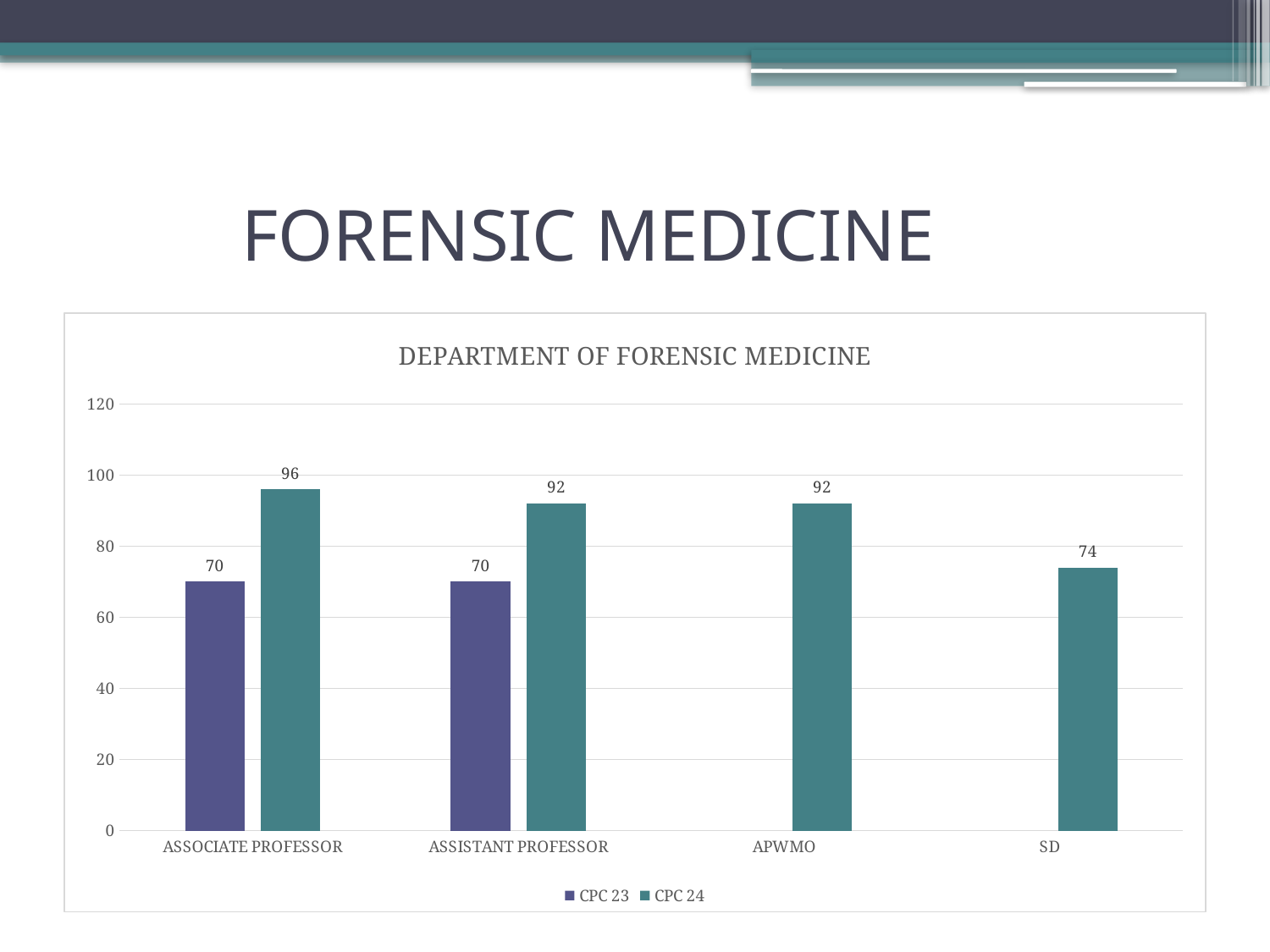
What is the CPC 24 value for APWMO? 92 How many series does the legend list? 2 What is the difference between the CPC 24 and CPC 23 values for ASSOCIATE PROFESSOR? 26 Which category has the highest CPC 24 value? ASSOCIATE PROFESSOR Which category has the lowest CPC 24 value? SD Which is larger for ASSISTANT PROFESSOR, the CPC 23 value or the CPC 24 value? CPC 24 What kind of chart is shown on the slide? Bar chart What is the CPC 23 value for ASSISTANT PROFESSOR? 70 How many categories are shown on the x axis? 4 What is the CPC 24 value for ASSOCIATE PROFESSOR? 96 What is the CPC 24 value for SD? 74 What is the title of the chart? DEPARTMENT OF FORENSIC MEDICINE